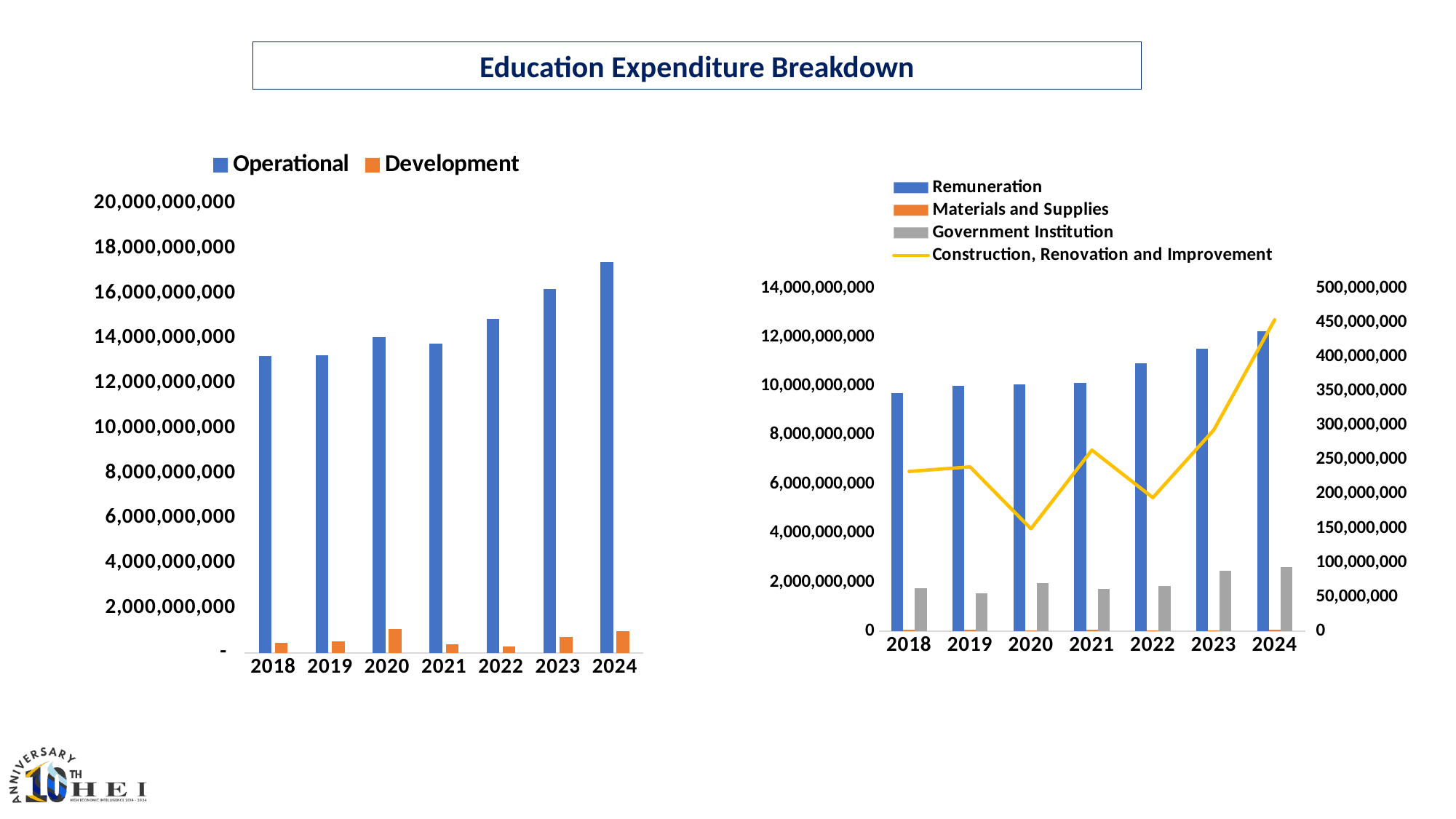
On the right chart, in which year is the Construction, Renovation and Improvement line at its lowest? 2020 On the right chart, how many series does the legend list? 4 On the left chart, is the Operational value for 2018 greater or less than 14,000,000,000? less What kind of chart is the left chart (Operational and Development)? Bar chart On the left chart, is the Operational value for 2024 greater or less than 16,000,000,000? greater On the left chart, in which year is Operational expenditure highest? 2024 On the right chart, which series is drawn as a line rather than bars? Construction, Renovation and Improvement On the left chart, in which year is Development expenditure highest? 2020 On the left chart (Operational and Development), how many series does the legend list? 2 On the left chart, how many years are shown on the x axis? 7 On the right chart, in which year is Remuneration highest? 2024 On the right chart, is the Construction, Renovation and Improvement value for 2024 greater or less than 400,000,000? greater